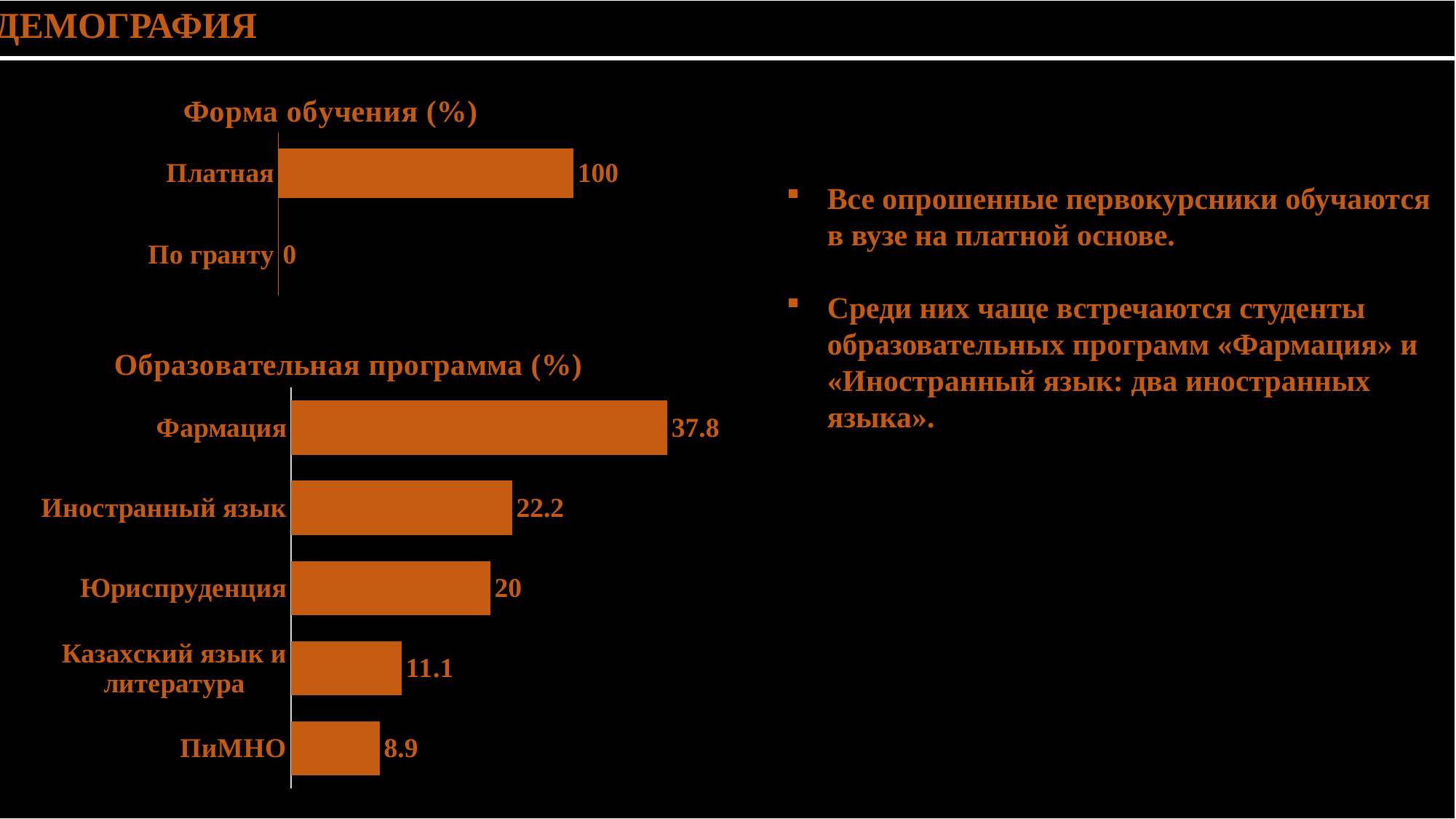
In the 'Образовательная программа (%)' chart, which category has the lowest value? ПиМНО In the 'Образовательная программа (%)' chart, which category has the highest value? Фармация In the 'Форма обучения (%)' chart, what is the value for Платная? 100 What type of chart is the 'Образовательная программа (%)' chart? Bar chart In the 'Образовательная программа (%)' chart, what is the difference between the values for Фармация and Иностранный язык? 15.6 In the 'Образовательная программа (%)' chart, which is larger: Юриспруденция or ПиМНО? Юриспруденция In the 'Форма обучения (%)' chart, how many categories are shown? 2 In the 'Образовательная программа (%)' chart, what is the value for Казахский язык и литература? 11.1 In the 'Форма обучения (%)' chart, what is the value for По гранту? 0 In the 'Образовательная программа (%)' chart, how many categories are shown? 5 In the 'Образовательная программа (%)' chart, what is the value for Иностранный язык? 22.2 In the 'Образовательная программа (%)' chart, what is the value for Фармация? 37.8